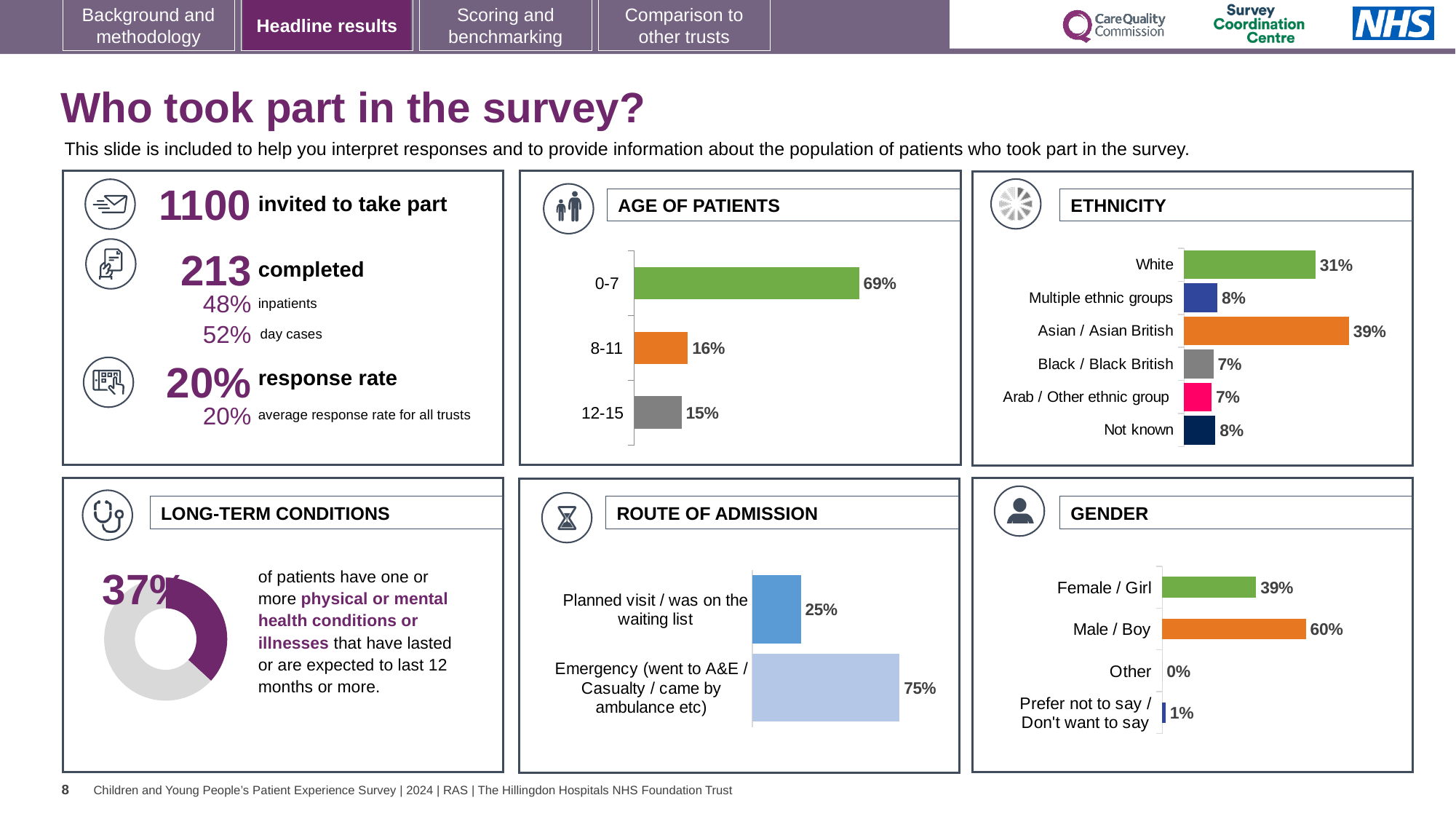
In the ETHNICITY chart, which ethnic group has the highest percentage? Asian / Asian British In the ETHNICITY chart, how many ethnic group categories are shown? 6 In the AGE OF PATIENTS chart, what is the difference between the 0-7 and 8-11 percentages? 53% In the GENDER chart, which category has the lowest percentage? Other In the ROUTE OF ADMISSION chart, what is the difference between the Emergency and Planned visit percentages? 50% In the ETHNICITY chart, what percentage of patients are White? 31% In the GENDER chart, what percentage of patients are Male / Boy? 60% In the AGE OF PATIENTS chart, what percentage of patients are aged 0-7? 69% In the AGE OF PATIENTS chart, which age group has the lowest percentage? 12-15 In the ROUTE OF ADMISSION chart, what percentage of patients came via Emergency (went to A&E / Casualty / came by ambulance etc)? 75% In the ETHNICITY chart, which is larger: Multiple ethnic groups or Black / Black British? Multiple ethnic groups What kind of chart is used in the LONG-TERM CONDITIONS panel? Donut chart